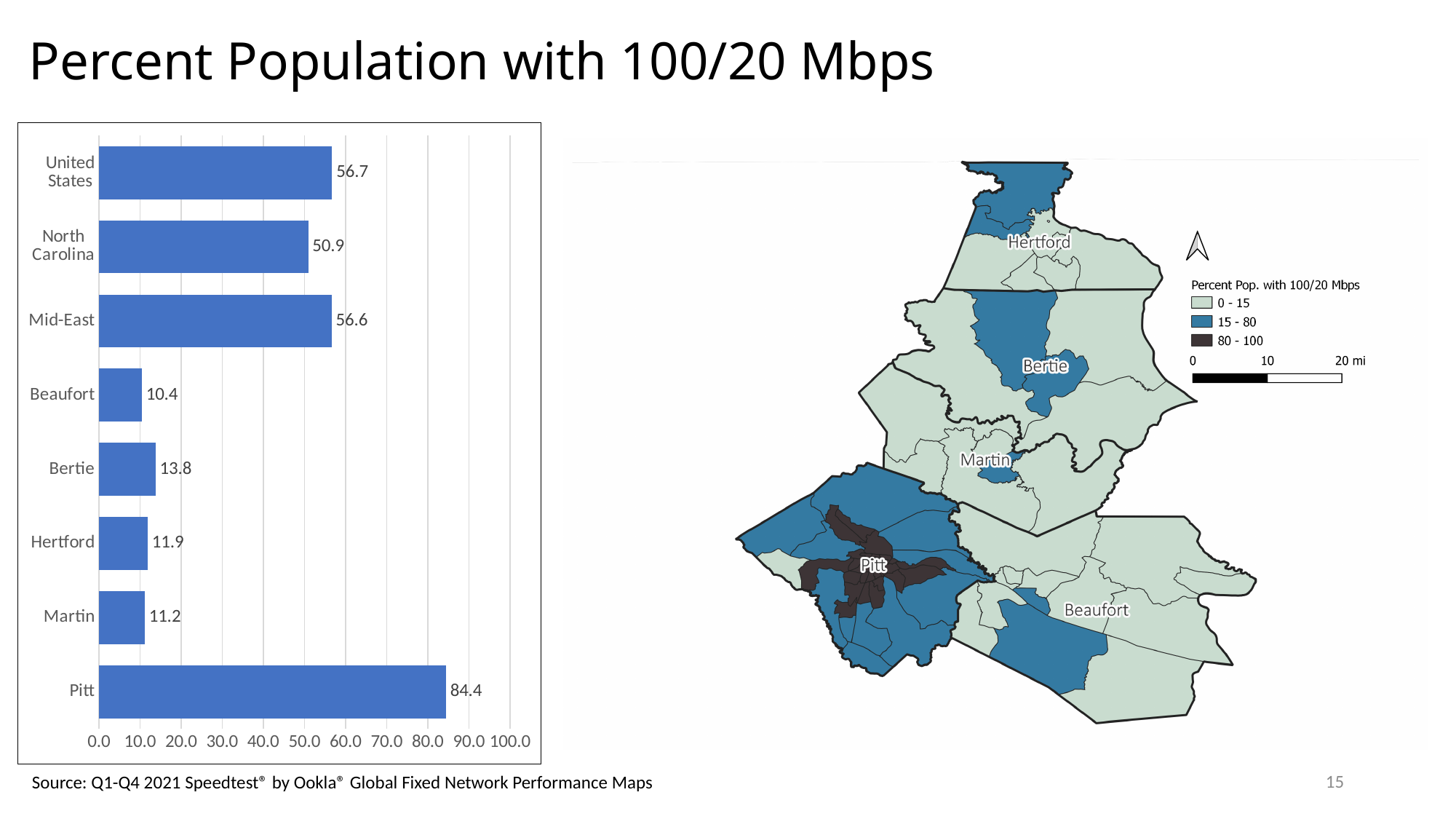
What kind of chart is shown on the left of the slide? bar chart What is the value for North Carolina in the bar chart? 50.9 Which category has the lowest value in the bar chart? Beaufort Which category has the highest value in the bar chart? Pitt What is the value for Pitt in the bar chart? 84.4 How many categories are shown in the bar chart? 8 Is the value for Mid-East in the bar chart greater or less than 50.0? greater What is the value for Beaufort in the bar chart? 10.4 What is the maximum value shown on the x axis of the bar chart? 100.0 What is the difference between the values for United States and North Carolina in the bar chart? 5.8 What is the difference between the values for Pitt and Bertie in the bar chart? 70.6 Which has a larger value in the bar chart, Hertford or Martin? Hertford